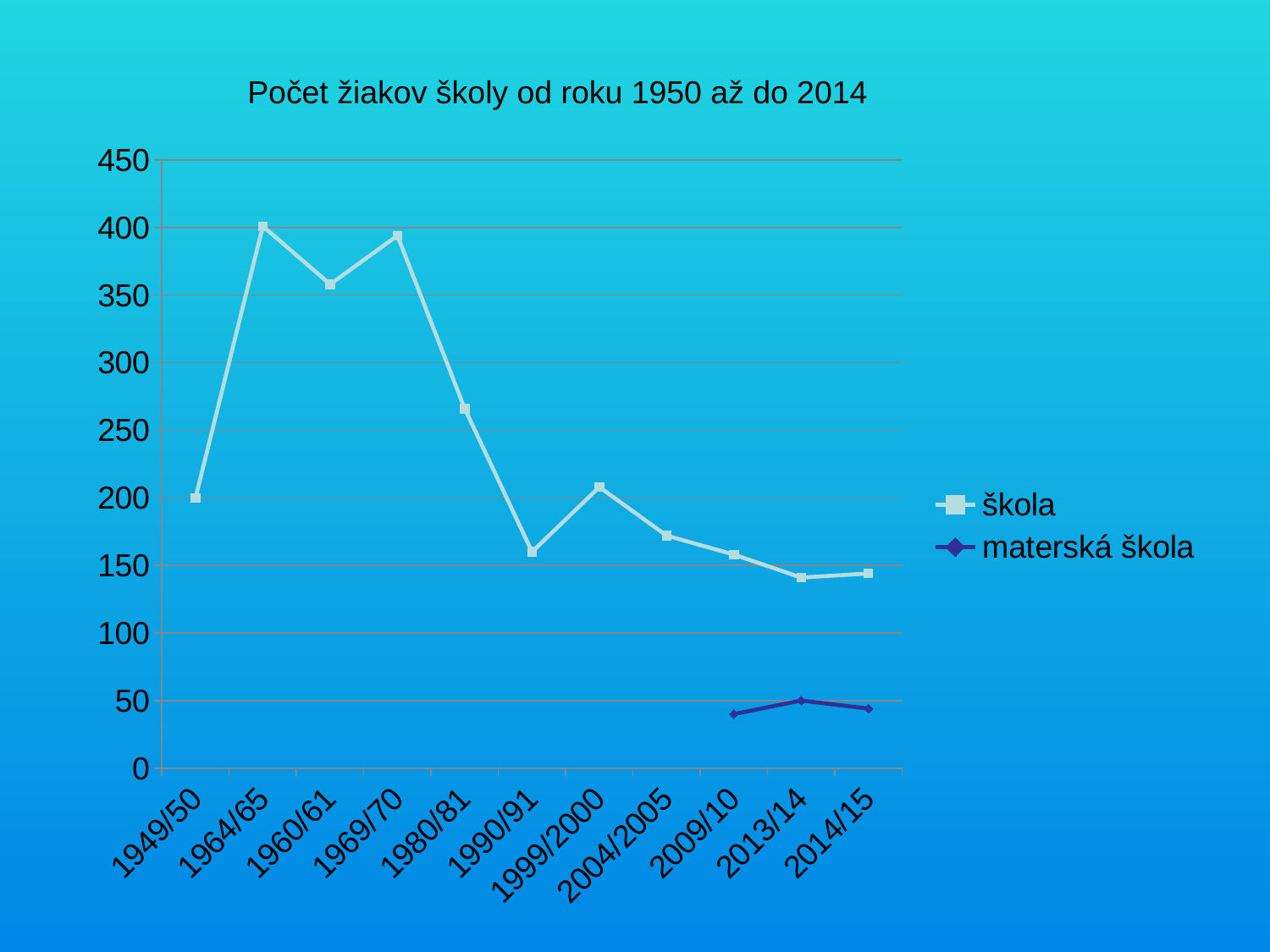
How many school-year categories are shown on the x axis? 11 Is the value for škola in 1964/65 greater or less than 350? greater Is the value for škola in 1980/81 greater or less than 250? greater Is the value for škola in 1990/91 greater or less than 200? less What are the two series named in the legend? škola and materská škola How many series does the legend list? 2 Which is larger for škola: the value in 1999/2000 or the value in 2004/2005? 1999/2000 In which school year is the materská škola series at its highest? 2013/14 Does the škola series rise or fall from 1969/70 to 1990/91? fall What type of chart is shown on the slide? line chart What is the title of the chart? Počet žiakov školy od roku 1950 až do 2014 Which is larger for škola: the value in 1980/81 or the value in 1990/91? 1980/81